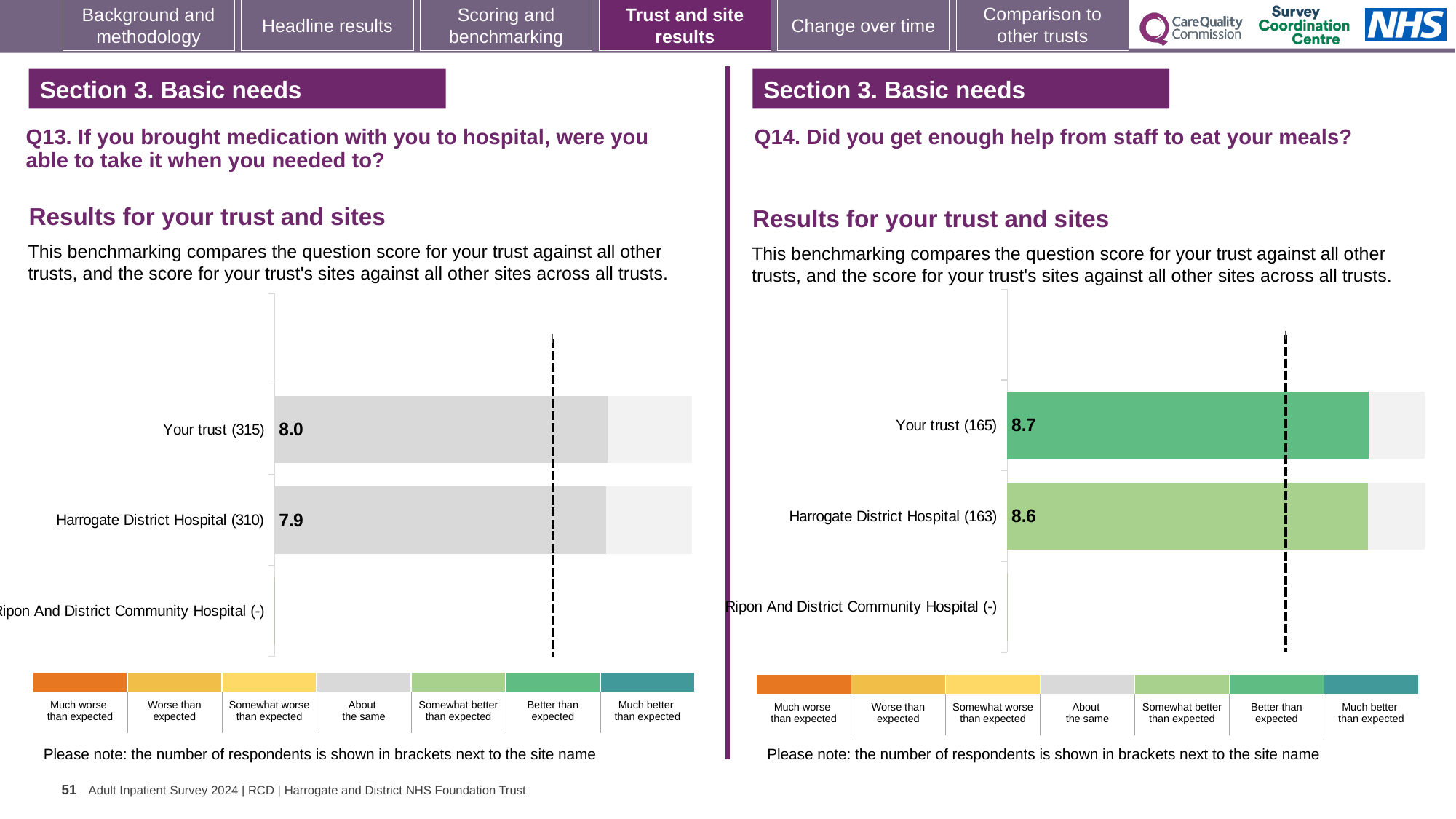
On the Q13 chart (left), what is the score for Harrogate District Hospital? 7.9 On the Q13 chart (left), what is the score for Your trust? 8.0 On the Q14 chart (right), what is the score for Your trust? 8.7 On the Q13 chart (left), how many respondents are shown in brackets for Your trust? 315 What kind of chart is used on the Q13 chart (left)? Bar chart On the Q14 chart (right), how many respondents are shown in brackets for Harrogate District Hospital? 163 On the Q14 chart (right), which benchmark category does the colour of the Your trust bar correspond to? Better than expected On the Q13 chart (left), what is the difference between the score for Your trust and the score for Harrogate District Hospital? 0.1 On the Q13 chart (left), which benchmark category does the colour of the Harrogate District Hospital bar correspond to? About the same On the Q14 chart (right), what is the difference between the score for Your trust and the score for Harrogate District Hospital? 0.1 On the Q14 chart (right), what is the score for Harrogate District Hospital? 8.6 On the Q14 chart (right), how many site/trust categories are listed on the vertical axis? 3